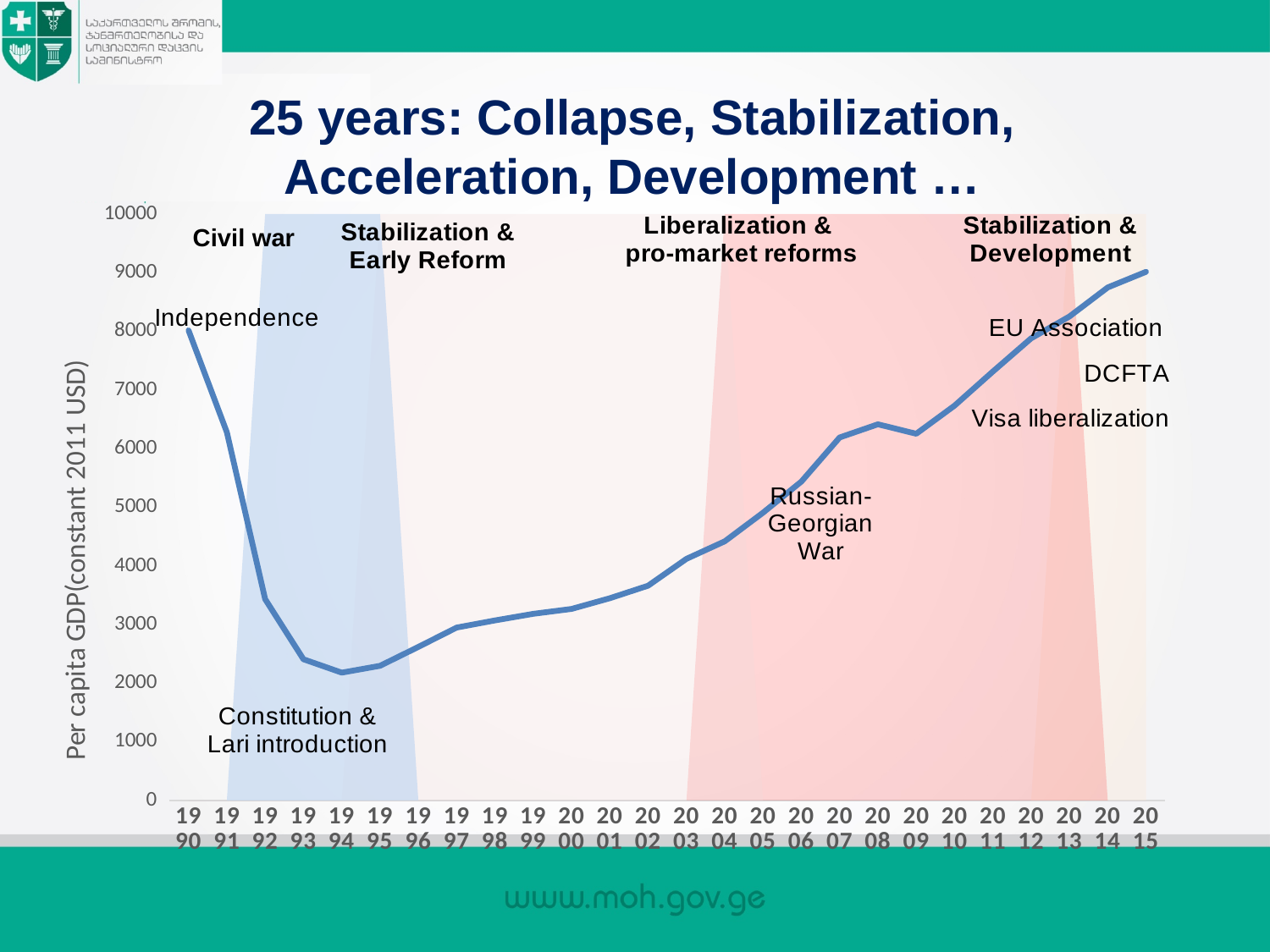
What is the title of the slide's chart? 25 years: Collapse, Stabilization, Acceleration, Development … What kind of chart is shown on the slide? line chart Is the value for 1994 greater or less than 3000? less Does per capita GDP rise or fall from 1990 to 1994? fall Which year has the higher per capita GDP, 1990 or 2015? 2015 How many years are plotted along the x axis? 26 What is the label of the vertical axis? Per capita GDP(constant 2011 USD) In which year is per capita GDP lowest? 1994 In which year is per capita GDP highest? 2015 Is the value for 1990 greater or less than 7000? greater Is the value for 2015 greater or less than 8000? greater